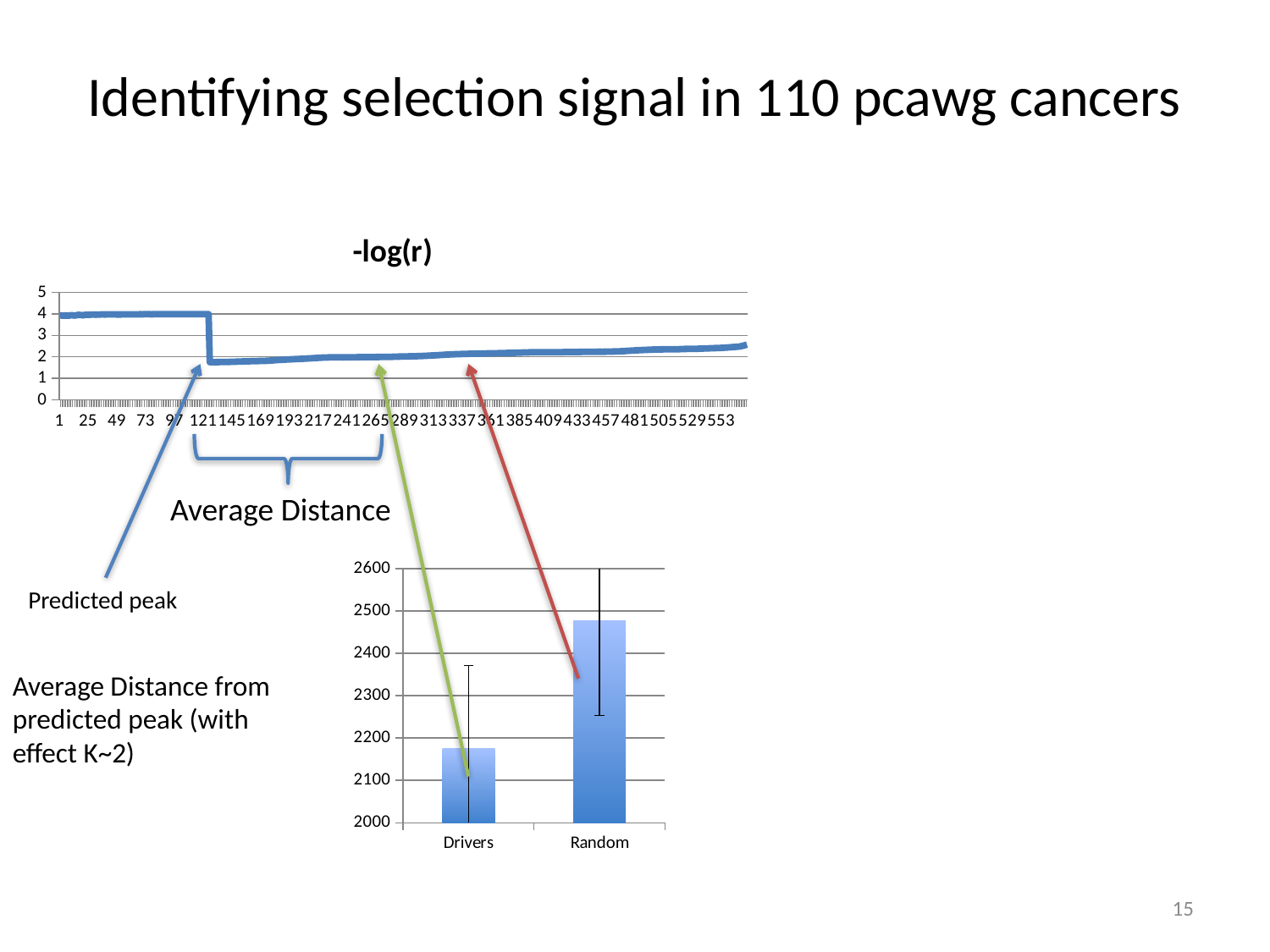
In the lower bar chart, which category has the lowest bar? Drivers In the lower bar chart, is the value for Drivers greater or less than 2100? greater What type of chart is the lower chart with the categories Drivers and Random? bar chart What is the title of the upper chart? -log(r) What type of chart is the chart titled "-log(r)"? line chart In the chart titled "-log(r)", is the value at x = 1 greater or less than 3? greater In the chart titled "-log(r)", what is the highest value shown on the y axis? 5 In the lower bar chart, is the value for Random greater or less than 2500? less In the lower bar chart, which category has the higher bar, Drivers or Random? Random In the lower bar chart, how many categories are shown on the x axis? 2